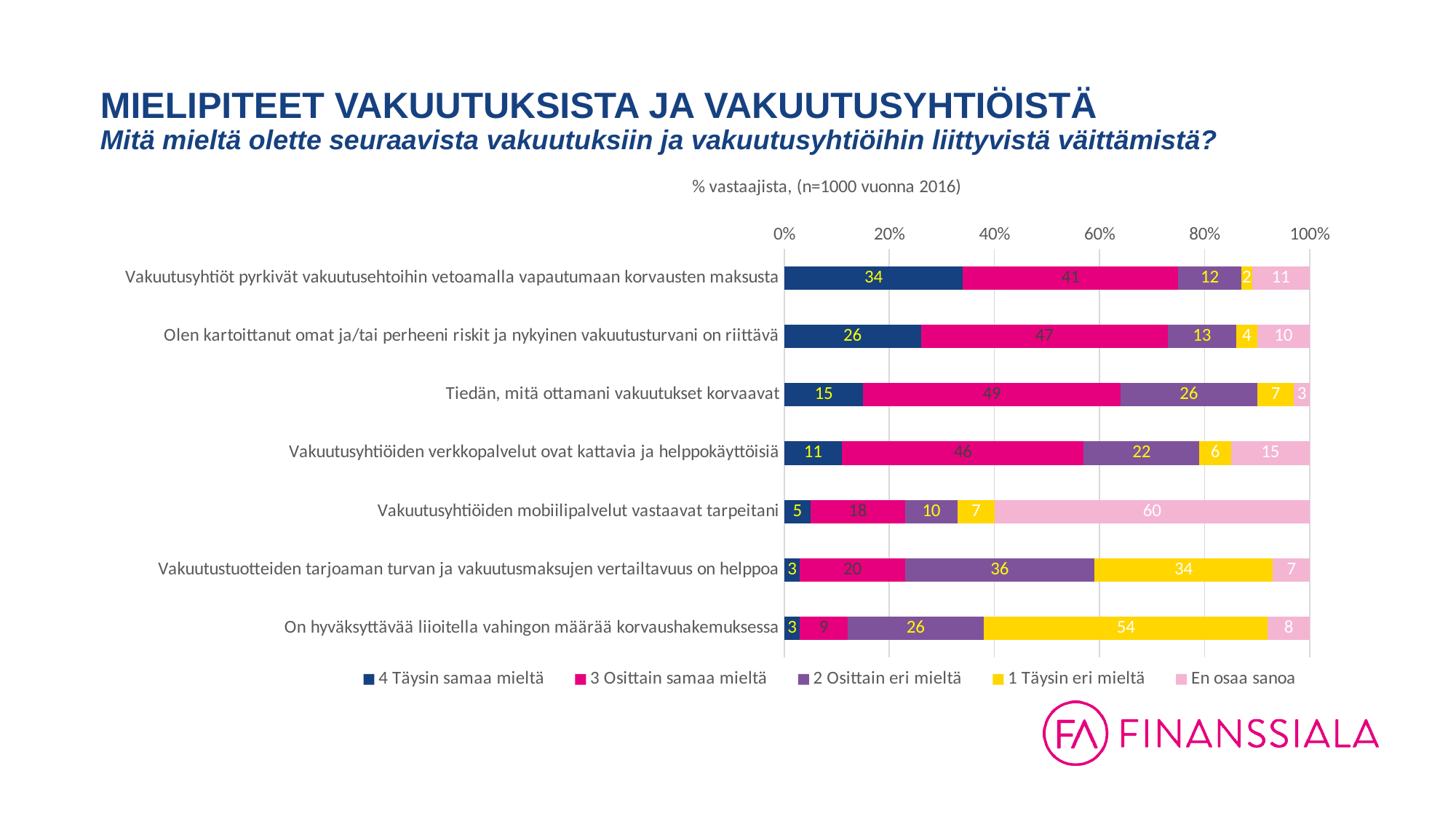
Which statement has the lowest value for "En osaa sanoa"? Tiedän, mitä ottamani vakuutukset korvaavat Which is larger: the "4 Täysin samaa mieltä" value for "Olen kartoittanut omat ja/tai perheeni riskit ja nykyinen vakuutusturvani on riittävä" or for "Tiedän, mitä ottamani vakuutukset korvaavat"? Olen kartoittanut omat ja/tai perheeni riskit ja nykyinen vakuutusturvani on riittävä What is the value of "En osaa sanoa" for "Vakuutusyhtiöiden mobiilipalvelut vastaavat tarpeitani"? 60 What is the value of "4 Täysin samaa mieltä" for "Vakuutusyhtiöt pyrkivät vakuutusehtoihin vetoamalla vapautumaan korvausten maksusta"? 34 Which statement has the highest value for "3 Osittain samaa mieltä"? Tiedän, mitä ottamani vakuutukset korvaavat What is the subtitle text shown above the chart describing the respondents? % vastaajista, (n=1000 vuonna 2016) What is the total of the stacked bar for "Vakuutusyhtiöiden verkkopalvelut ovat kattavia ja helppokäyttöisiä"? 100 What is the difference between the "2 Osittain eri mieltä" values for "Vakuutustuotteiden tarjoaman turvan ja vakuutusmaksujen vertailtavuus on helppoa" and "Vakuutusyhtiöiden mobiilipalvelut vastaavat tarpeitani"? 26 How many statements (categories) are shown in the chart? 7 What kind of chart is shown on the slide? Stacked bar chart How many series does the legend list? 5 What is the value of "1 Täysin eri mieltä" for "On hyväksyttävää liioitella vahingon määrää korvaushakemuksessa"? 54